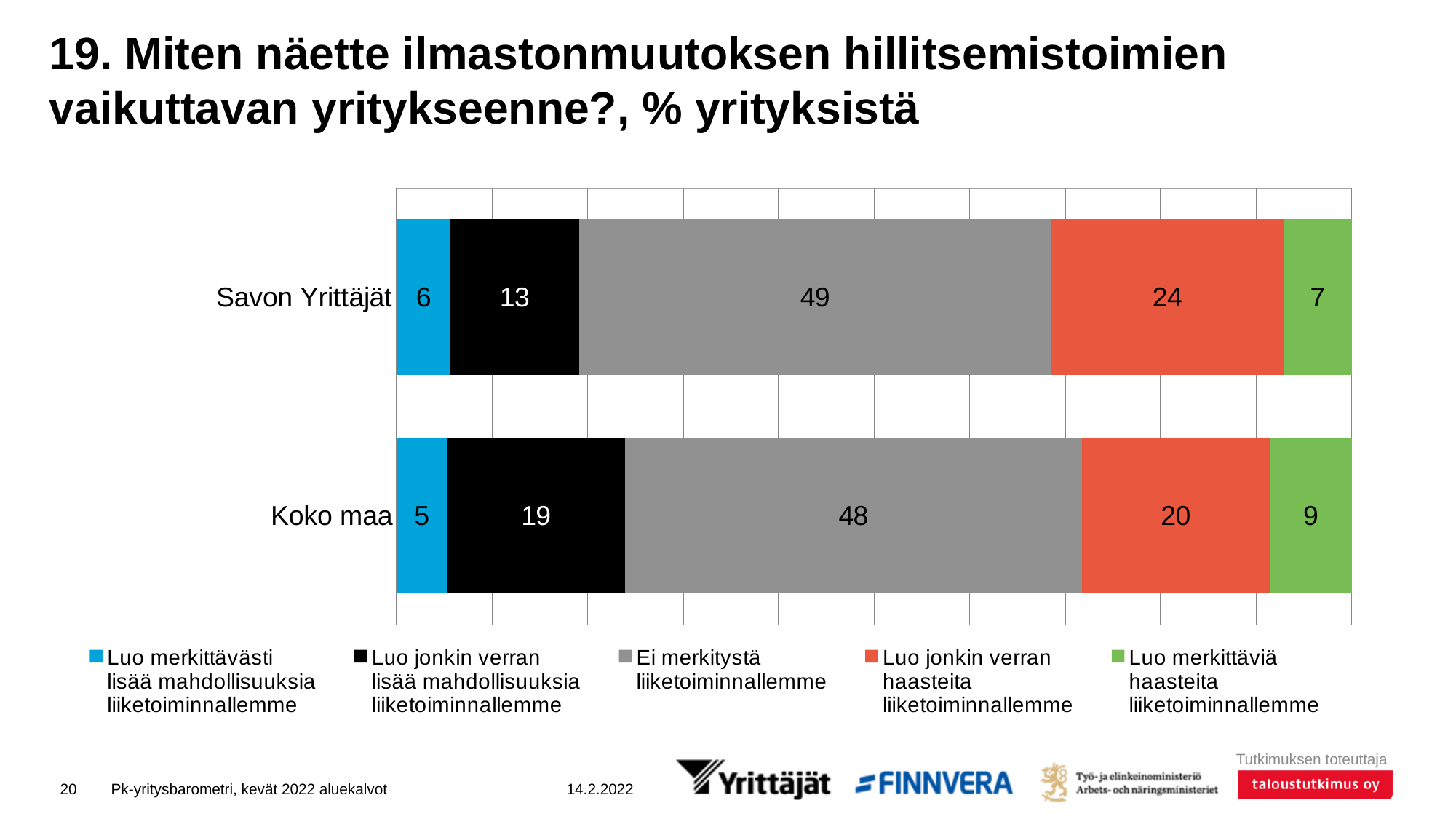
Which has a larger value for "Luo jonkin verran haasteita liiketoiminnallemme", Savon Yrittäjät or Koko maa? Savon Yrittäjät Which response category has the lowest value for Savon Yrittäjät? Luo merkittävästi lisää mahdollisuuksia liiketoiminnallemme How many series does the legend list? 5 What is the difference between the "Luo jonkin verran lisää mahdollisuuksia liiketoiminnallemme" values for Koko maa and Savon Yrittäjät? 6 How many categories (bars) are shown on the y axis? 2 What is the value for "Ei merkitystä liiketoiminnallemme" for Savon Yrittäjät? 49 What is the value for "Luo jonkin verran lisää mahdollisuuksia liiketoiminnallemme" for Koko maa? 19 What kind of chart is shown on the slide? Stacked bar chart What is the value for "Luo merkittäviä haasteita liiketoiminnallemme" for Savon Yrittäjät? 7 Which response category has the highest value for Koko maa? Ei merkitystä liiketoiminnallemme What is the total of the stacked bar for Savon Yrittäjät? 99 What is the value for "Luo jonkin verran haasteita liiketoiminnallemme" for Koko maa? 20